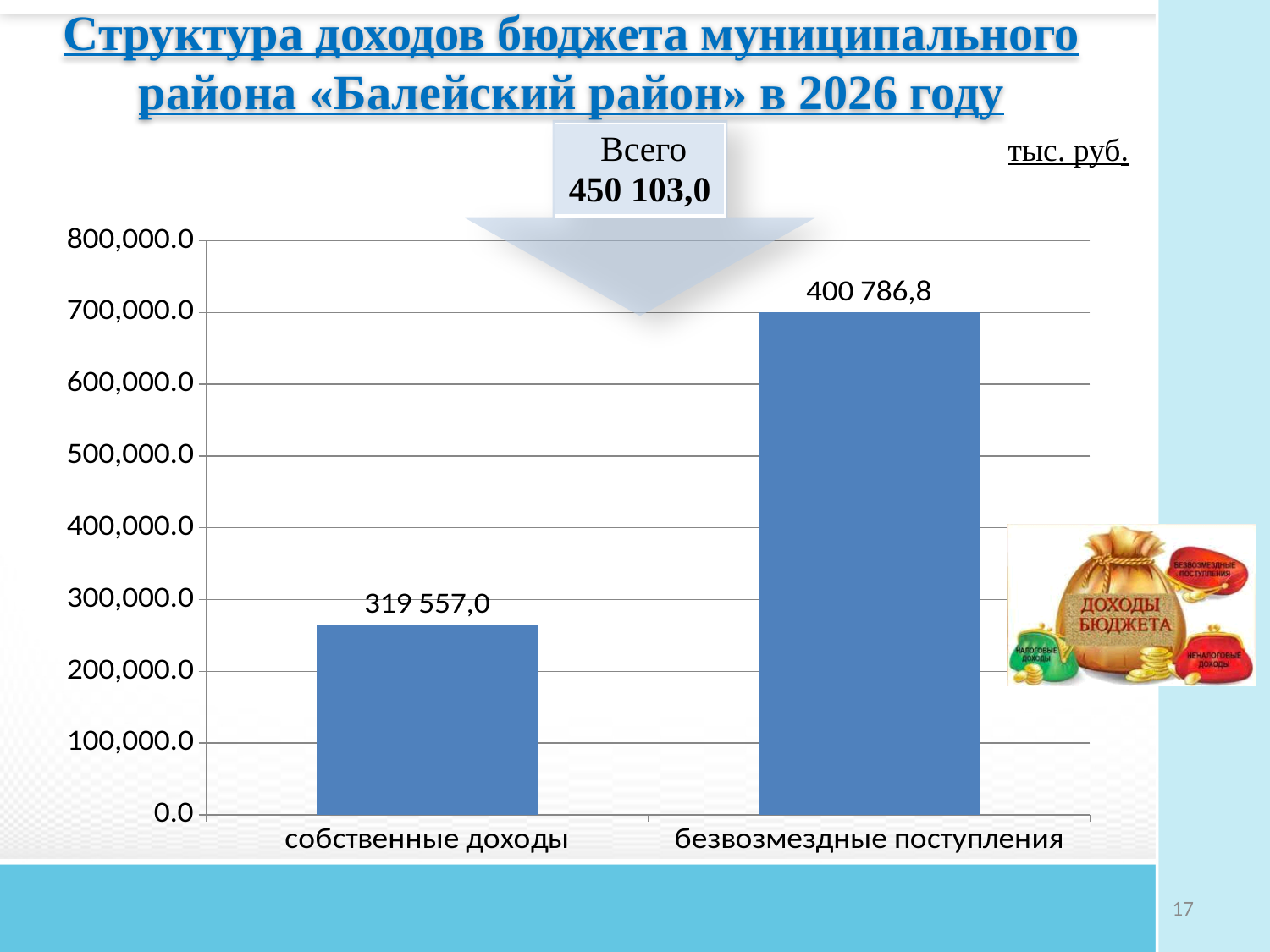
How many categories are shown on the chart? 2 What is the value for безвозмездные поступления? 400 786,8 Which is larger, собственные доходы or безвозмездные поступления? безвозмездные поступления What total (Всего) is shown above the chart? 450 103,0 What is the value for собственные доходы? 319 557,0 What kind of chart is shown on the slide? bar chart What unit of measurement is indicated for the chart values? тыс. руб. What is the difference between the labelled values for безвозмездные поступления and собственные доходы? 81 229,8 Which category has the highest value? безвозмездные поступления Which category has the lowest value? собственные доходы Is the value for безвозмездные поступления greater or less than 300,000.0? greater